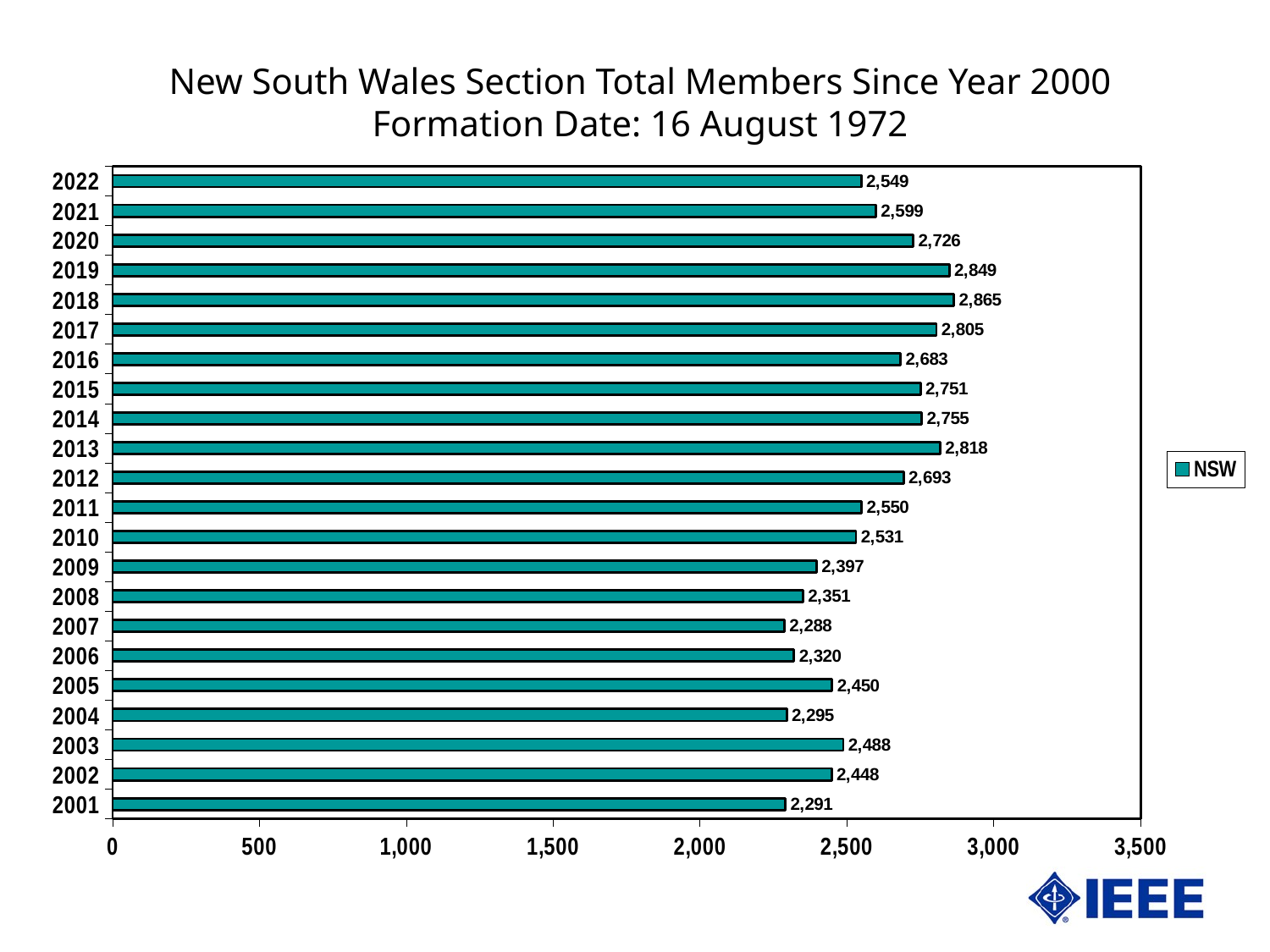
Which is larger, the value for 2013 or the value for 2017? 2013 What is the value for 2022? 2,549 What is the difference between the values for 2019 and 2020? 123 Which year has the lowest value? 2007 What is the value for 2018? 2,865 How many series does the legend list? 1 What kind of chart is shown? bar chart Which year has the highest value? 2018 What series name appears in the legend? NSW What is the value for 2001? 2,291 How many years are shown on the chart? 22 Is the value for 2009 greater or less than 2,500? less